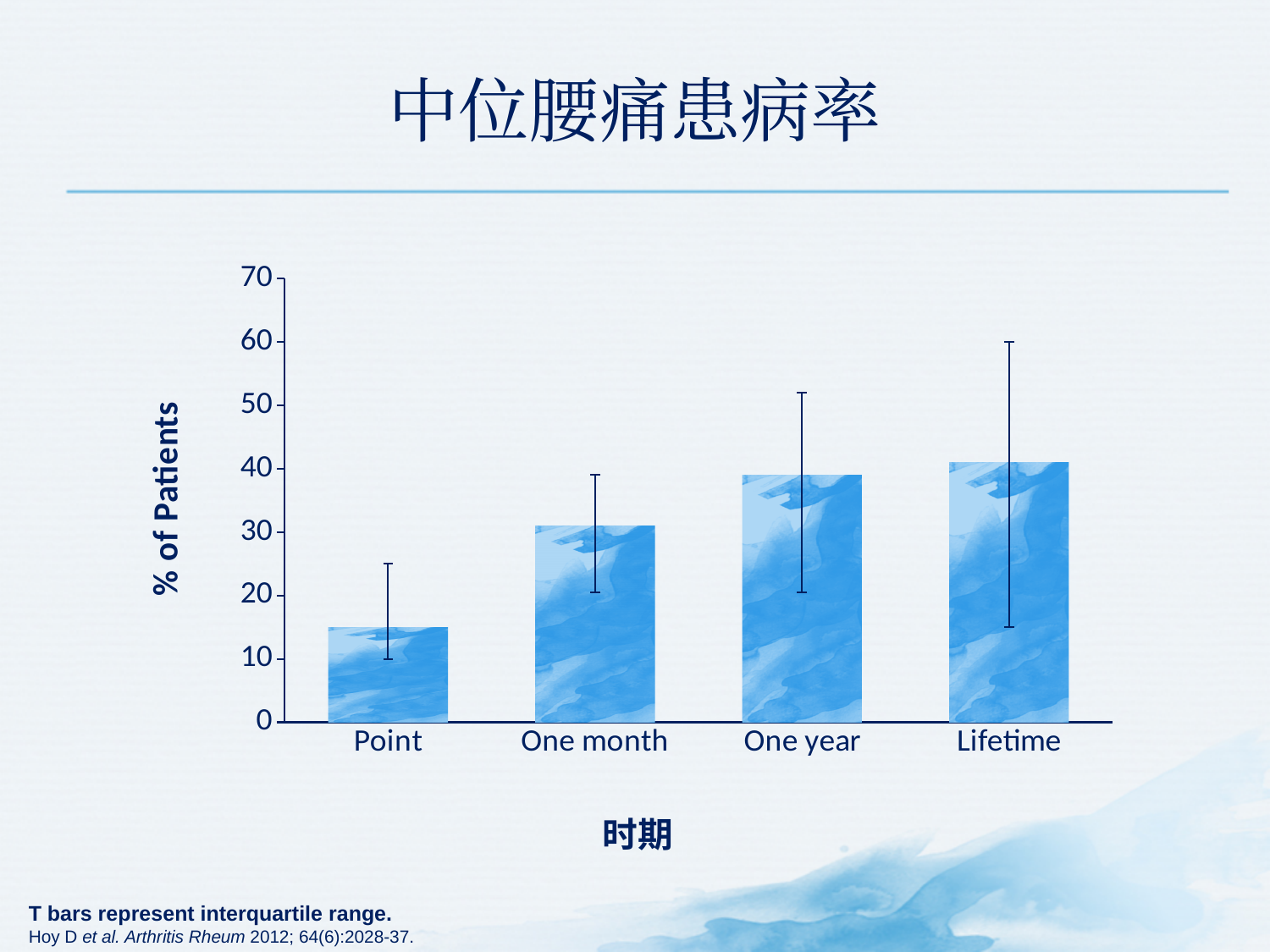
What kind of chart is shown on the slide? bar chart Is the value for Lifetime greater or less than 50? less Is the value for One year greater or less than 30? greater Is the value for Point greater or less than 20? less Which time period has the lowest % of patients? Point Do the values rise or fall from Point to Lifetime along the x axis? rise What is the label on the y axis? % of Patients According to the note on the slide, what do the T bars represent? interquartile range Which is larger, the value for Point or the value for One month? One month How many time periods are plotted on the x axis? 4